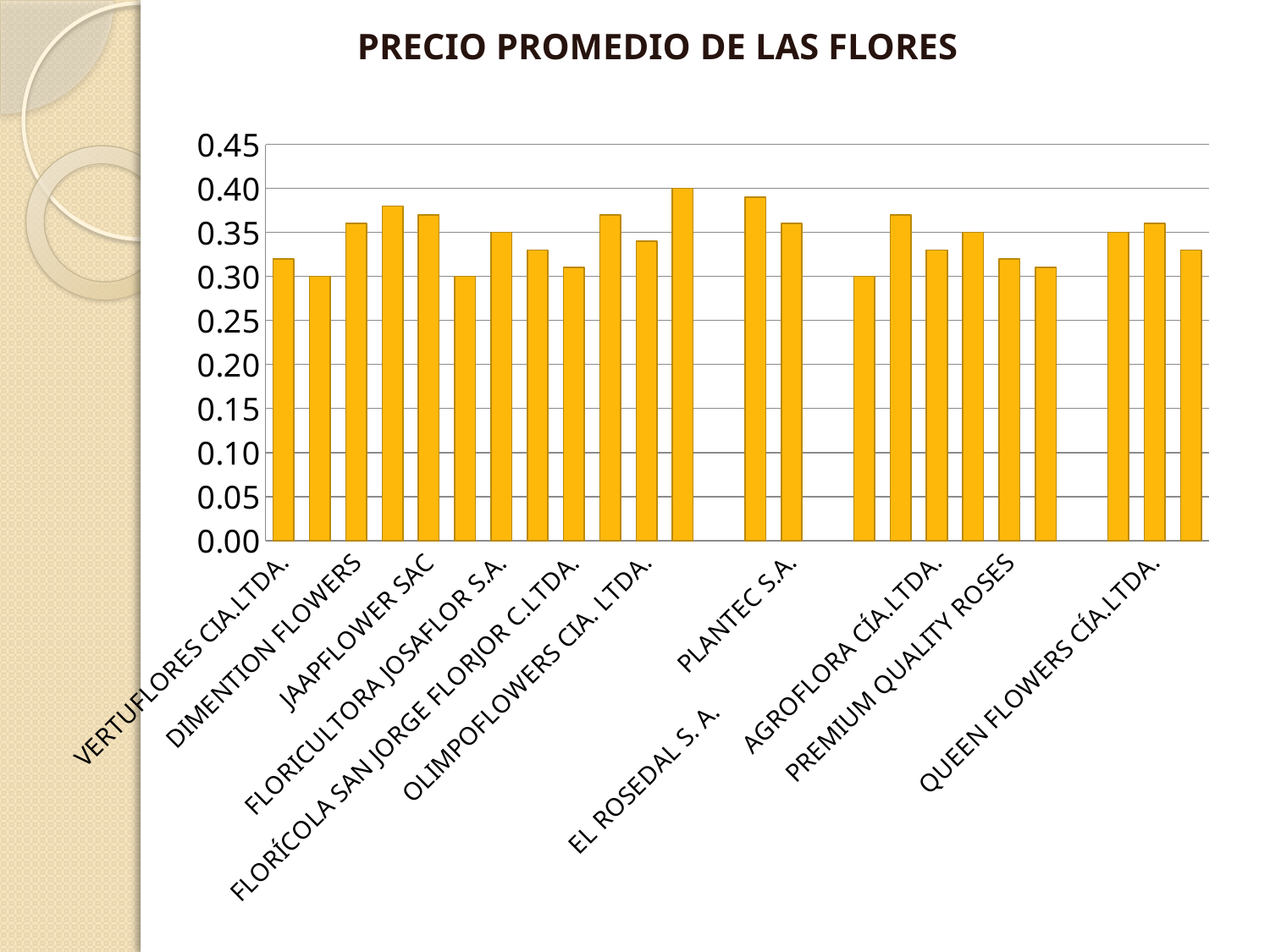
What is the lowest value reached by any bar in the chart? 0.30 What kind of chart is shown on the slide? bar chart Is the value for FLORÍCOLA SAN JORGE FLORJOR C.LTDA. greater or less than 0.35? less What is the highest value reached by any bar in the chart? 0.40 Is the value for VERTUFLORES CIA.LTDA. greater or less than 0.35? less Is the value for VERTUFLORES CIA.LTDA. greater or less than 0.30? greater What is the maximum value shown on the vertical axis? 0.45 Which has the larger value, VERTUFLORES CIA.LTDA. or DIMENTION FLOWERS? DIMENTION FLOWERS What is the title of the chart? PRECIO PROMEDIO DE LAS FLORES